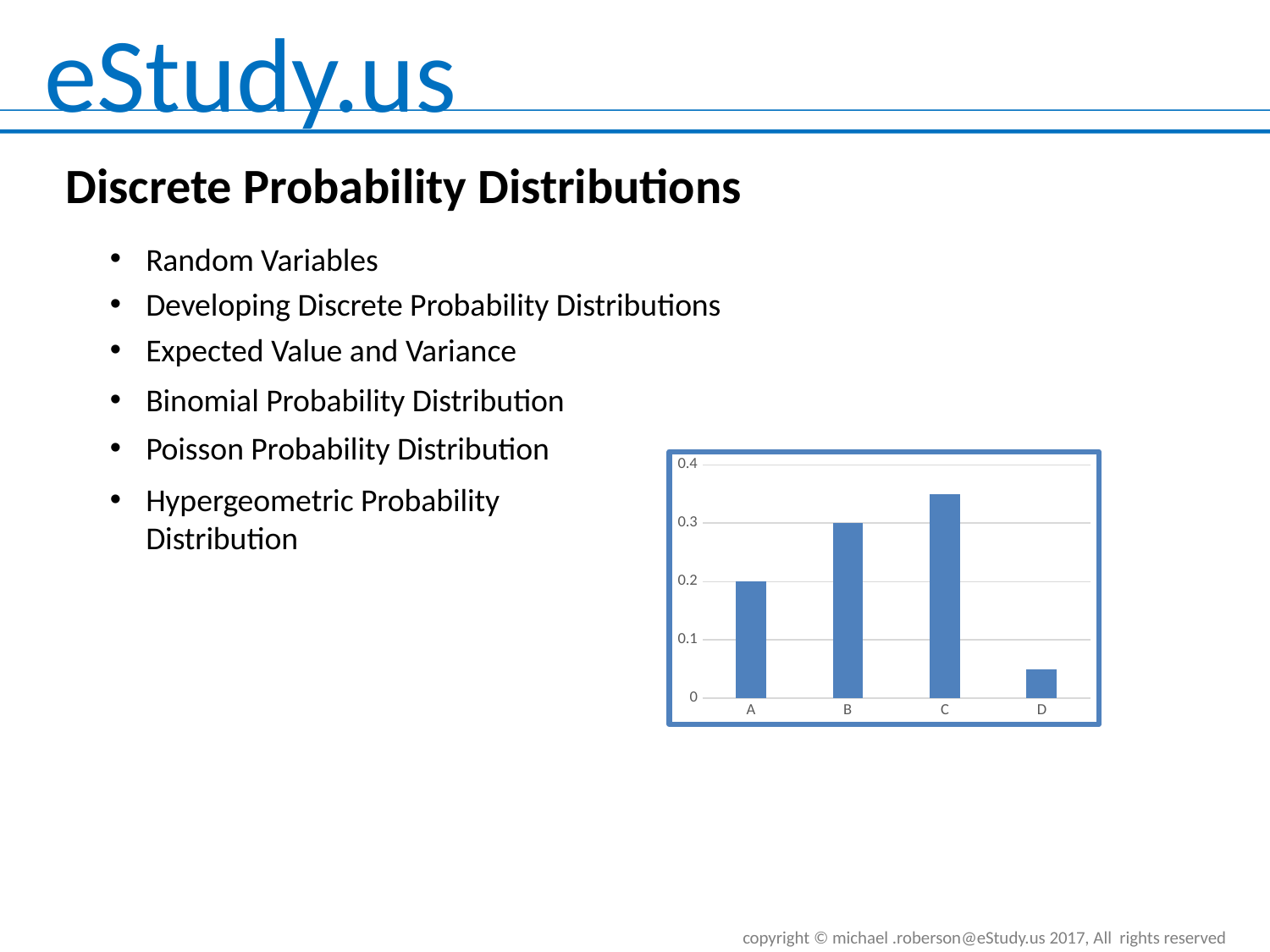
Do the values rise or fall from A to C? rise What is the value for category A? 0.2 What is the value for category B? 0.3 How many categories are shown on the x axis? 4 Is the value for C greater or less than 0.3? greater Is the value for D greater or less than 0.1? less What is the difference between the values for B and A? 0.1 Which category has the lowest bar? D Which is larger, the value for C or the value for D? C Which is larger, the value for A or the value for B? B Which category has the highest bar? C What kind of chart is shown on the slide? bar chart